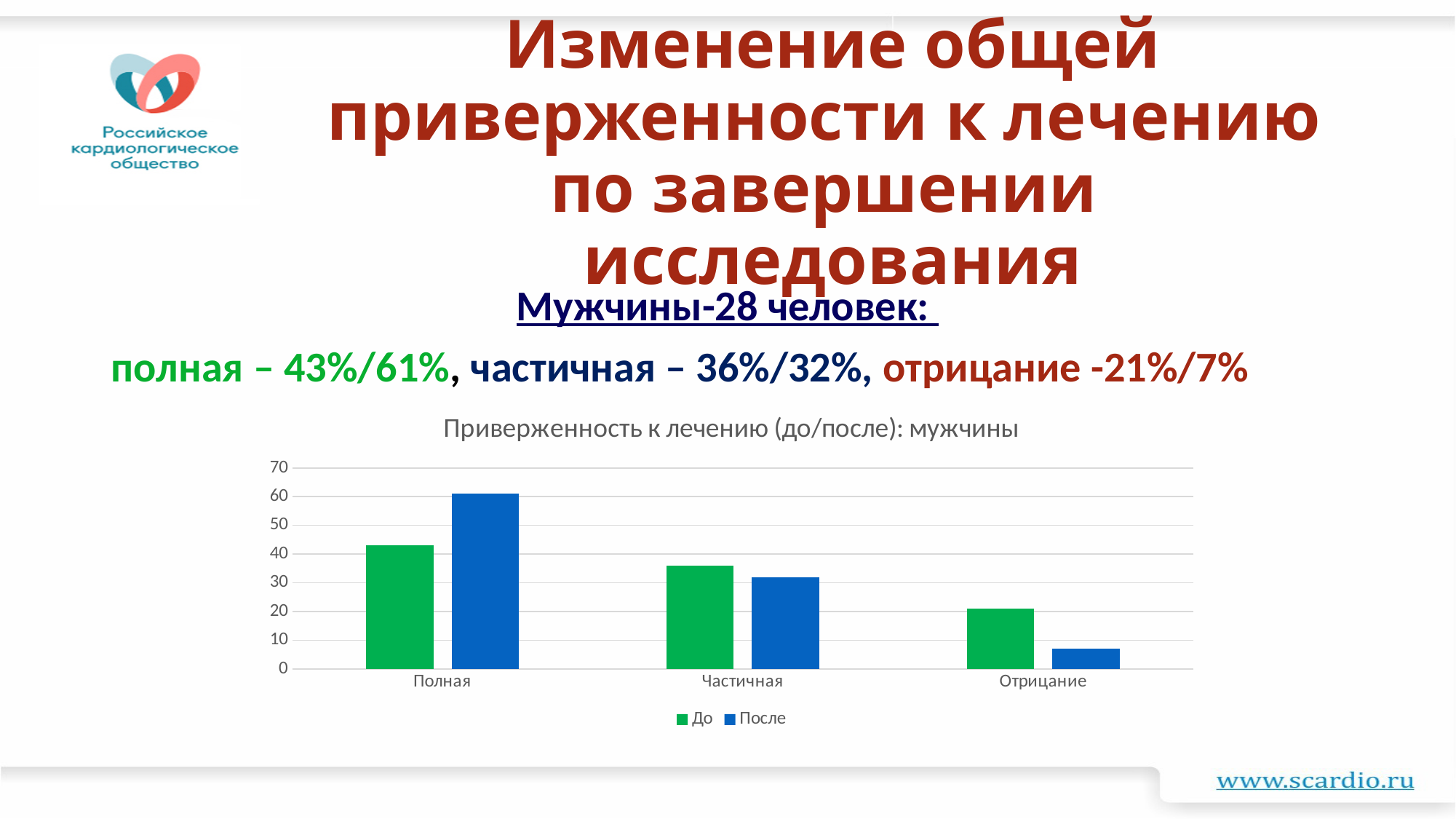
Which category has the highest 'После' bar? Полная How many series does the chart legend list? 2 What is the title of the chart? Приверженность к лечению (до/после): мужчины Which category has the lowest 'До' bar? Отрицание According to the slide, what is the 'После' value for Отрицание? 7% What kind of chart is shown on the slide? bar chart According to the slide, what is the 'До' value for Полная? 43% What is the difference between the 'После' and 'До' values for Полная, using the values printed on the slide? 18% How many categories are shown on the x axis of the chart? 3 What are the two series named in the chart legend? До, После Is the 'После' value for Полная greater or less than 50? greater For Частичная, which bar is taller: До or После? До